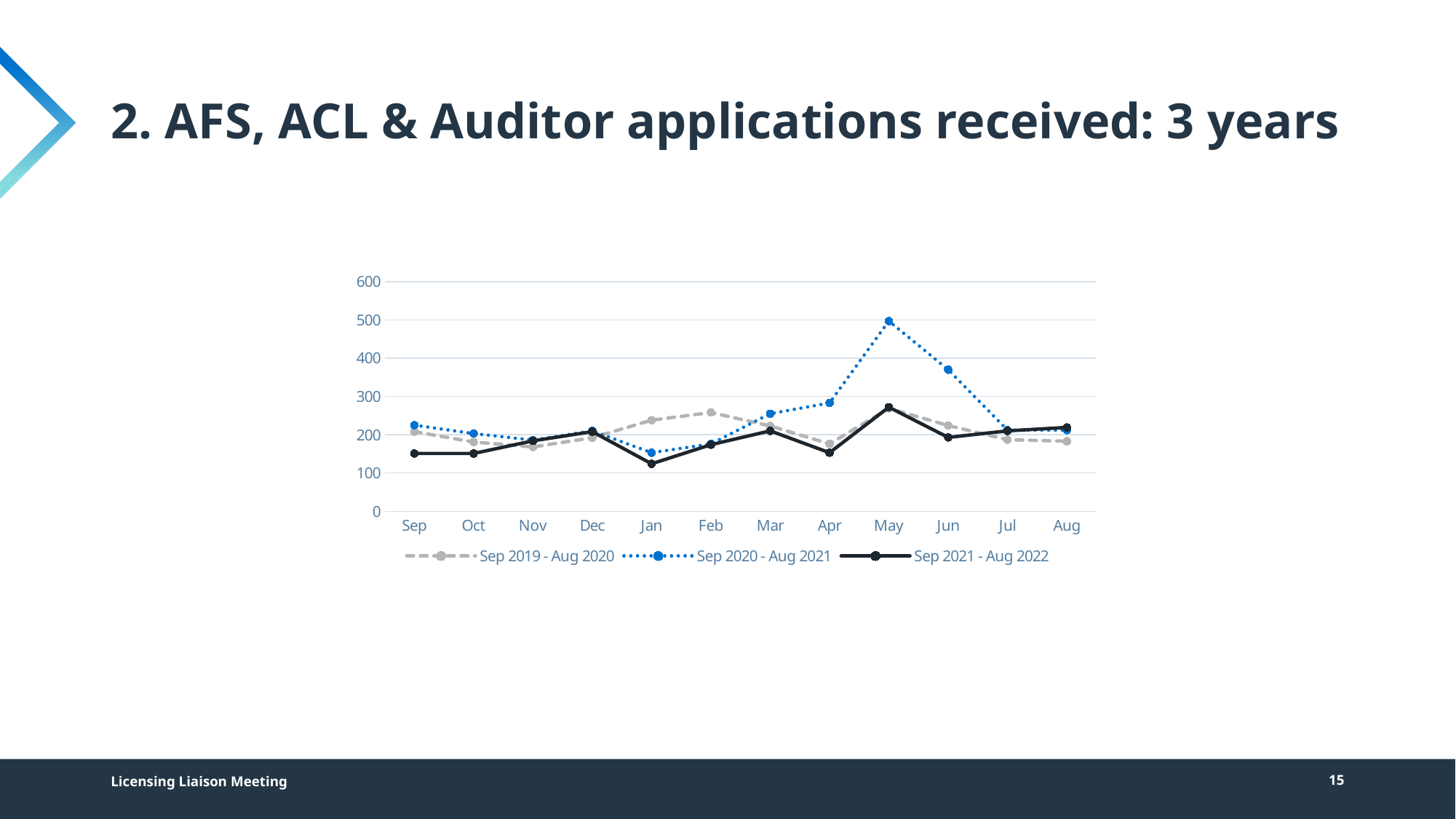
Is the value for May in the Sep 2020 - Aug 2021 series greater or less than 400? greater Does the Sep 2020 - Aug 2021 series rise or fall from May to Jul? Fall In which month does the Sep 2021 - Aug 2022 series reach its lowest value? Jan Is the value for Jun in the Sep 2020 - Aug 2021 series greater or less than 300? greater How many months are shown along the x axis? 12 Which series is drawn with a dotted blue line? Sep 2020 - Aug 2021 In which month does the Sep 2020 - Aug 2021 series reach its highest value? May How many series does the legend list? 3 In which month does the Sep 2021 - Aug 2022 series reach its highest value? May In May, which series has the larger value: Sep 2020 - Aug 2021 or Sep 2021 - Aug 2022? Sep 2020 - Aug 2021 What kind of chart is shown on the slide? Line chart Is the value for Jan in the Sep 2021 - Aug 2022 series greater or less than 200? less